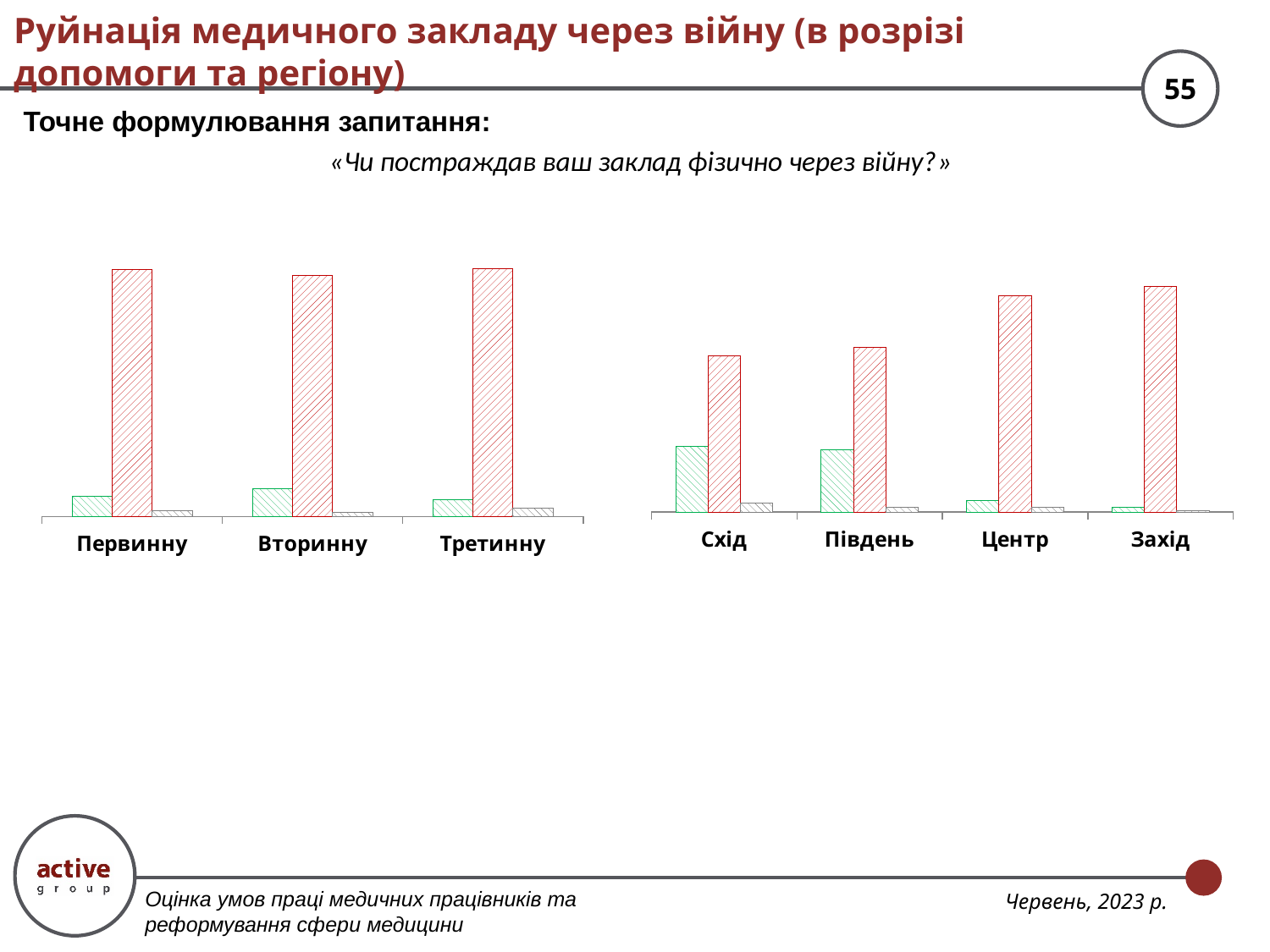
In the right chart, is the red hatched bar for Схід larger or smaller than the red hatched bar for Центр? smaller What kind of chart is the right chart (Схід, Південь, Центр, Захід)? bar chart In the right chart, is the green hatched bar for Схід larger or smaller than the green hatched bar for Захід? larger How many categories are shown on the x axis of the left chart? 3 In the right chart, how many bars are plotted for each region? 3 In the right chart, do the green hatched bars generally rise or fall from Схід to Захід? fall How many categories are shown on the x axis of the right chart? 4 In the right chart, do the red hatched bars generally rise or fall from Схід to Захід? rise What kind of chart is the left chart (Первинну, Вторинну, Третинну)? bar chart What is the title of the slide containing the two charts? Руйнація медичного закладу через війну (в розрізі допомоги та регіону) In the left chart, which bar is the tallest within the Первинну category: the green, the red or the grey hatched bar? the red hatched bar What survey question is quoted above the charts? «Чи постраждав ваш заклад фізично через війну?»